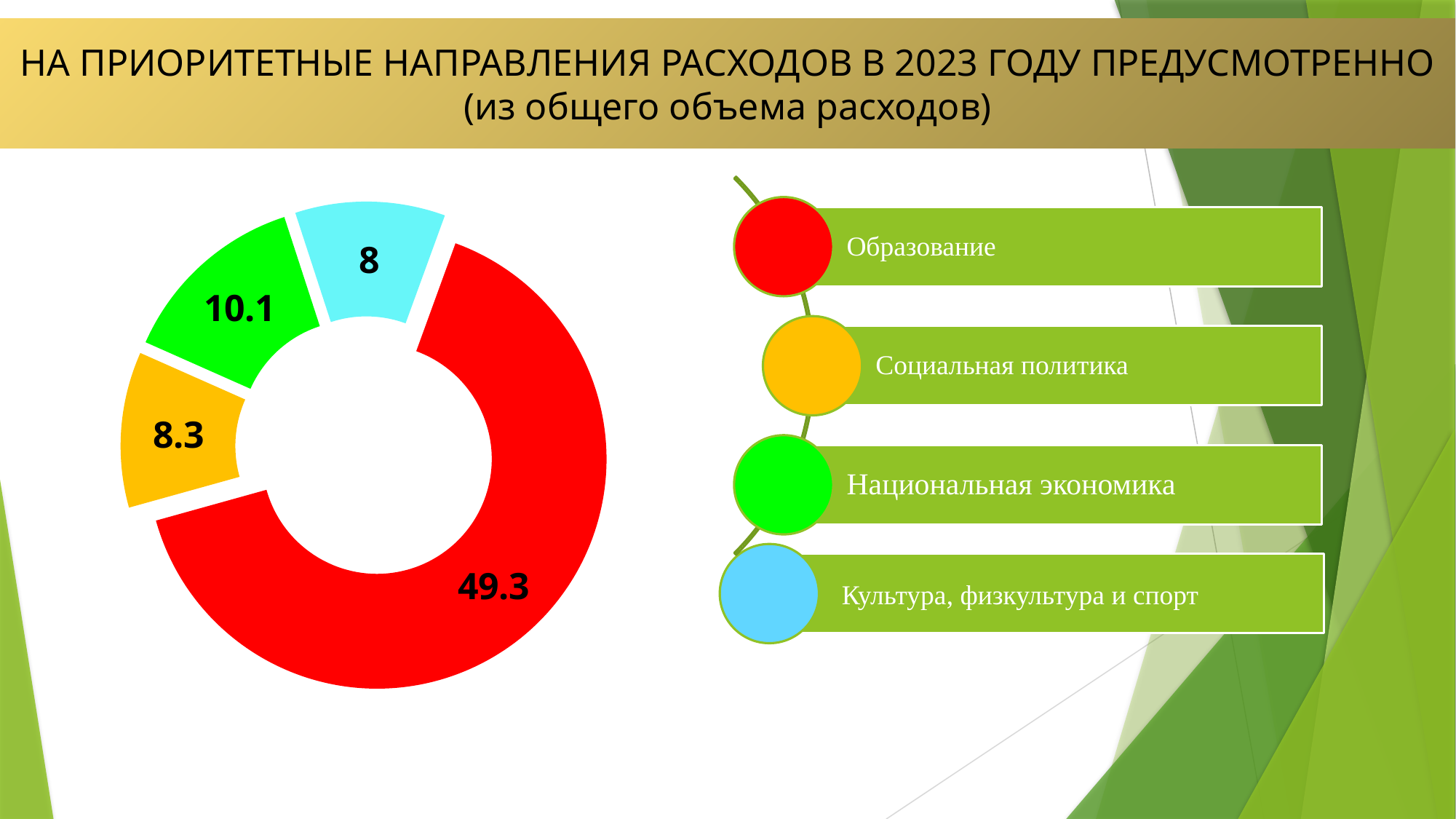
What value is shown for Социальная политика on the chart? 8.3 Which category has the largest slice on the chart? Образование Which is larger: the value for Национальная экономика or the value for Социальная политика? Национальная экономика Which category has the smallest slice on the chart? Культура, физкультура и спорт What value is shown for Национальная экономика on the chart? 10.1 What value is shown for Культура, физкультура и спорт on the chart? 8 What kind of chart is shown on the slide? doughnut chart What value is shown for Образование on the chart? 49.3 What is the difference between the values for Образование and Национальная экономика? 39.2 Which colour represents Социальная политика on the chart? yellow What is the difference between the values for Национальная экономика and Социальная политика? 1.8 How many slices does the chart have? 4